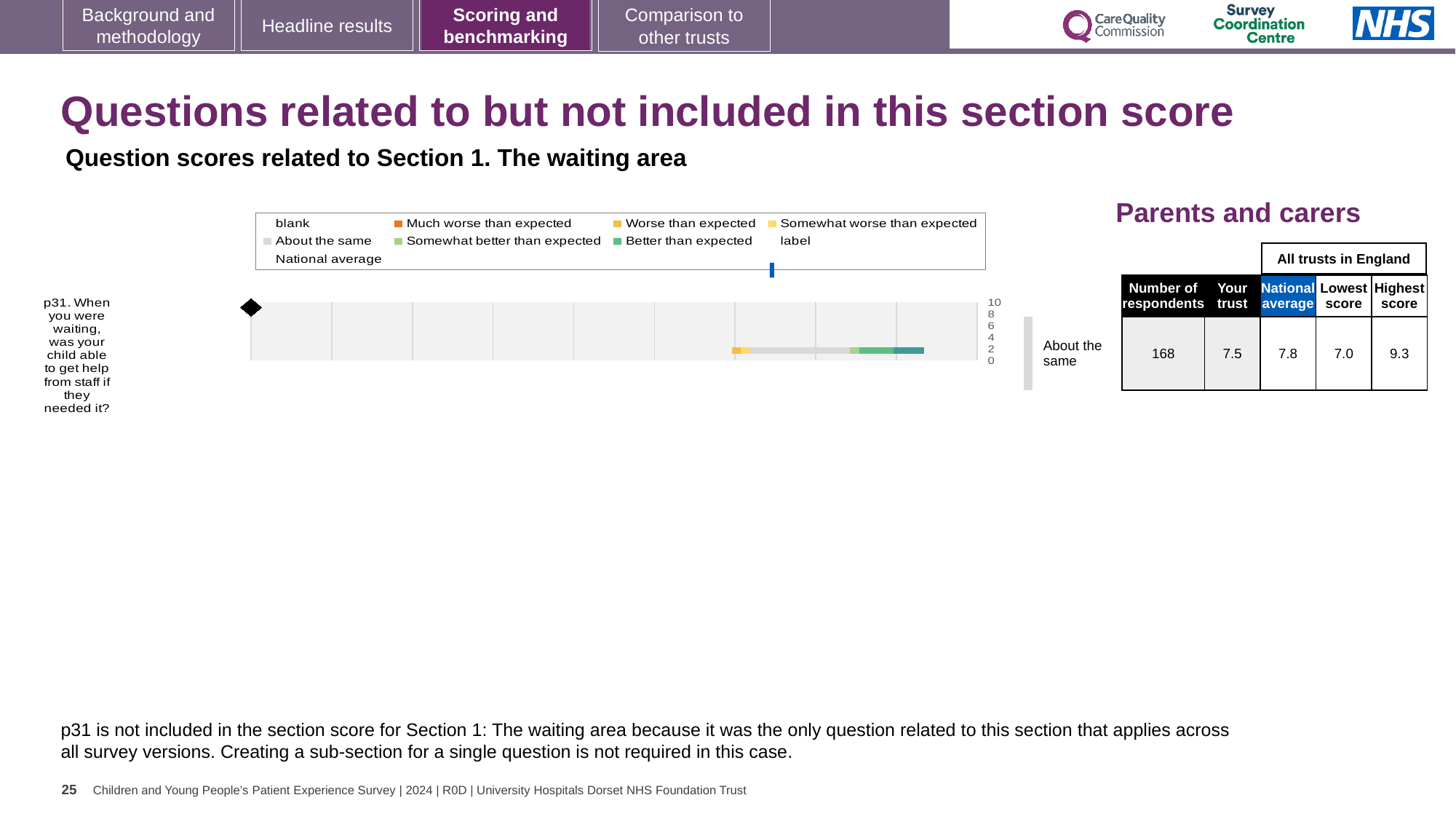
Which is larger for p31, the 'Your trust' score or the national average score? National average How many survey questions are plotted in the chart? 1 What is the difference between the highest score and the lowest score for p31 in the table beside the chart? 2.3 According to the table beside the chart, what is the highest score among all trusts in England for p31? 9.3 According to the table beside the chart, what is the 'Your trust' score for p31? 7.5 According to the table beside the chart, what is the national average score for p31? 7.8 According to the table beside the chart, how many respondents answered p31? 168 Which question is plotted in the chart? p31. When you were waiting, was your child able to get help from staff if they needed it? What benchmark category label is shown to the right of the chart for p31? About the same According to the table beside the chart, what is the lowest score among all trusts in England for p31? 7.0 What kind of chart is shown on the slide for question p31? bar chart What is the highest tick value shown on the chart's axis? 10